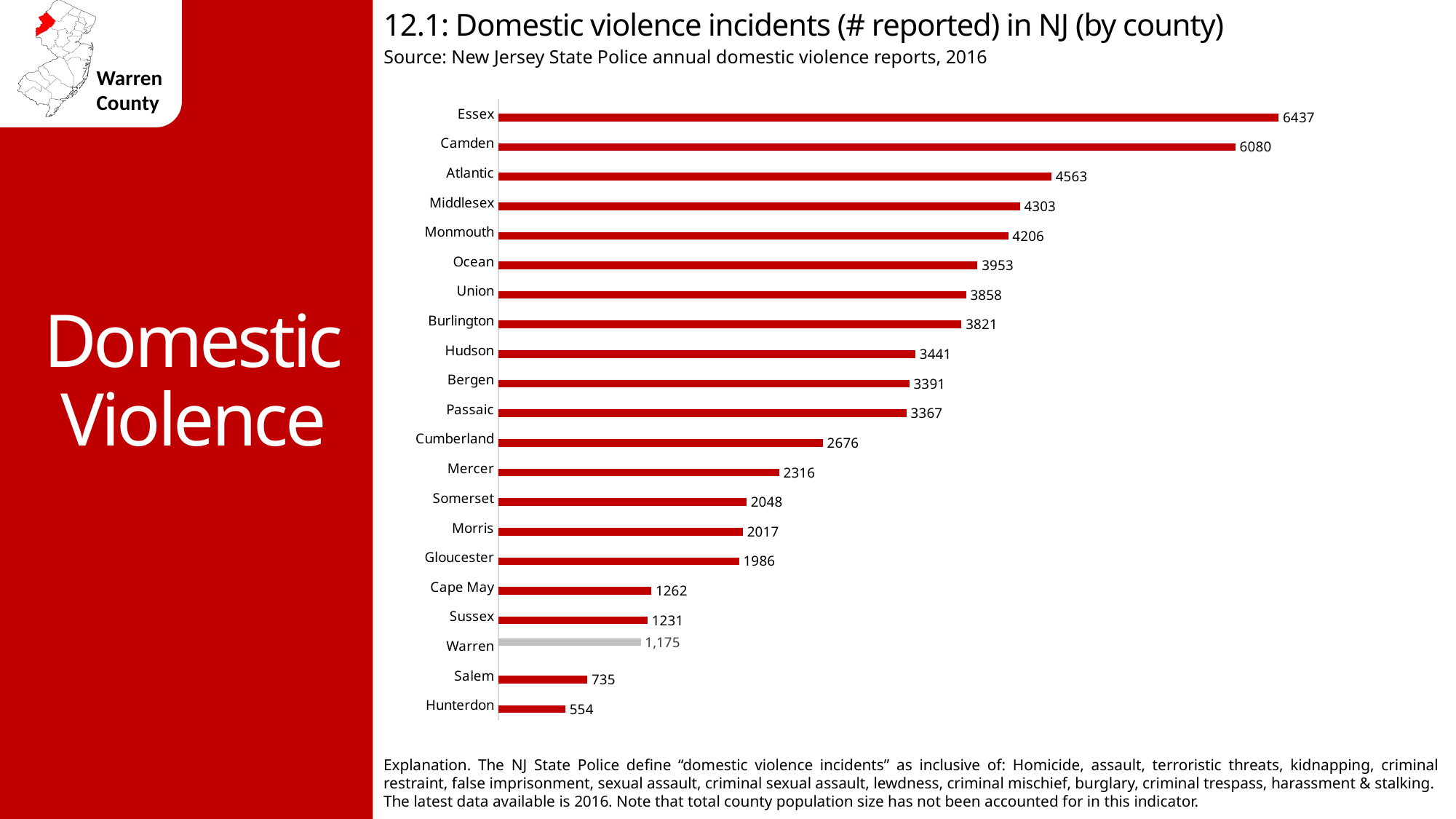
Which county has the highest number of reported domestic violence incidents? Essex Which county's bar is shown in grey rather than red? Warren What type of chart is used on this slide? Bar chart What is the number of reported domestic violence incidents for Morris County? 2017 Which county has more reported incidents, Atlantic or Middlesex? Atlantic What is the difference between the number of incidents in Essex and Camden? 357 Which county has more reported incidents, Salem or Hunterdon? Salem Which county has the lowest number of reported domestic violence incidents? Hunterdon What is the difference between the number of incidents in Sussex and Warren? 56 What is the number of reported domestic violence incidents for Essex County? 6437 How many counties are shown in the chart? 21 What is the number of reported domestic violence incidents for Warren County? 1,175